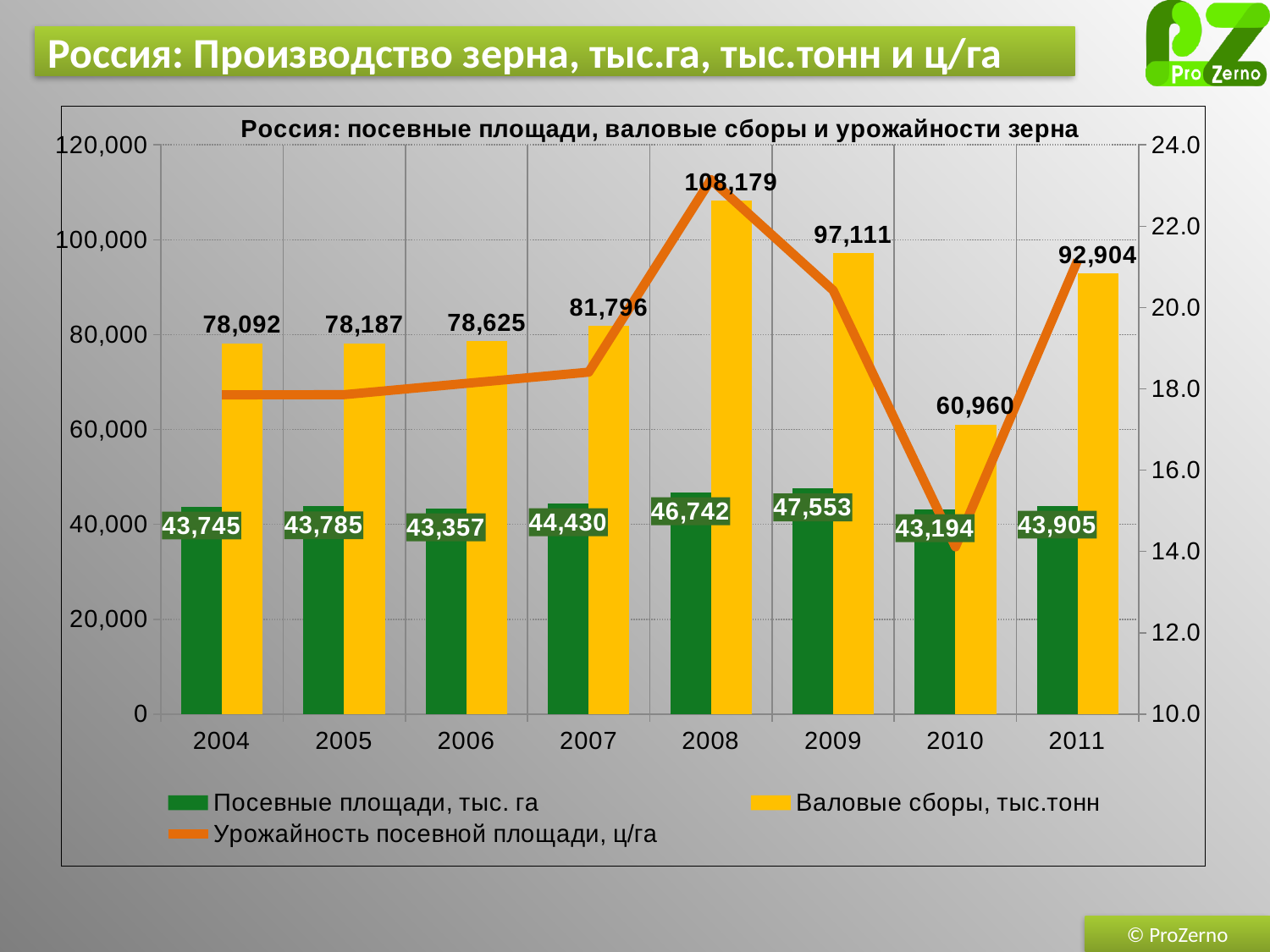
Is the value of Урожайность посевной площади, ц/га for 2010 greater or less than 16.0? less What is the difference between Валовые сборы in 2008 and 2009? 11,068 How many series does the legend list? 3 In which year is Посевные площади, тыс. га the lowest? 2010 Does Валовые сборы, тыс.тонн rise or fall from 2004 to 2008? rise What is the value of Валовые сборы, тыс.тонн for 2008? 108,179 What is the value of Посевные площади, тыс. га for 2009? 47,553 Which year has the larger Валовые сборы, 2009 or 2011? 2009 What is the difference between Посевные площади in 2009 and 2010? 4,359 Is the value of Урожайность посевной площади, ц/га for 2008 greater or less than 22.0? greater In which year is Валовые сборы, тыс.тонн the highest? 2008 How many years are shown on the x axis? 8